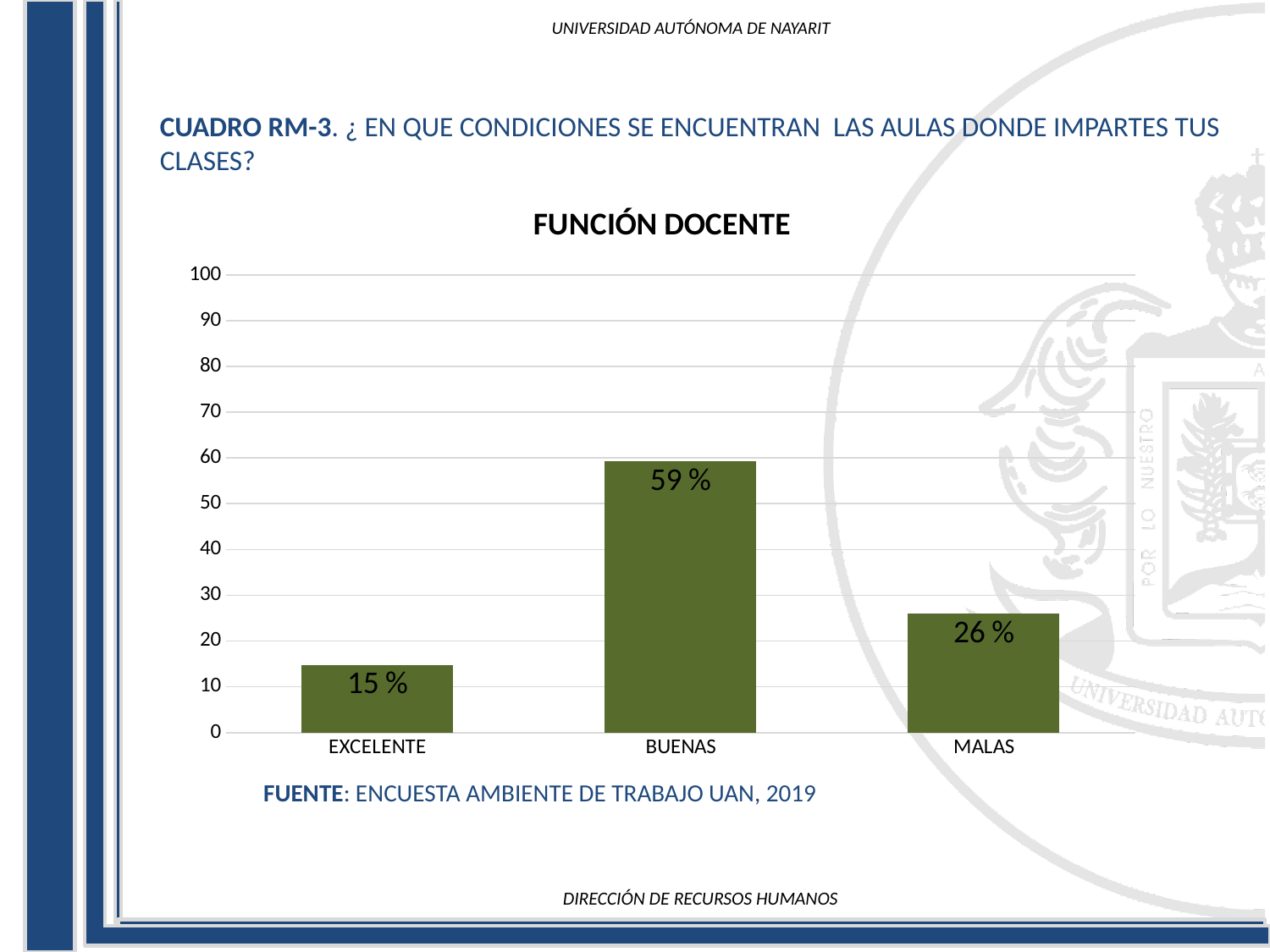
What is the value for BUENAS? 59 % Which category has the highest value? BUENAS How many categories are shown on the x axis? 3 Is the value for BUENAS greater or less than 50? greater What is the difference between the values for BUENAS and MALAS? 33 % What is the value for MALAS? 26 % What kind of chart is shown on the slide? bar chart Which category has the lowest value? EXCELENTE What is the value for EXCELENTE? 15 % Which is larger, the value for MALAS or the value for EXCELENTE? MALAS What is the difference between the values for MALAS and EXCELENTE? 11 % What is the title of the chart? FUNCIÓN DOCENTE